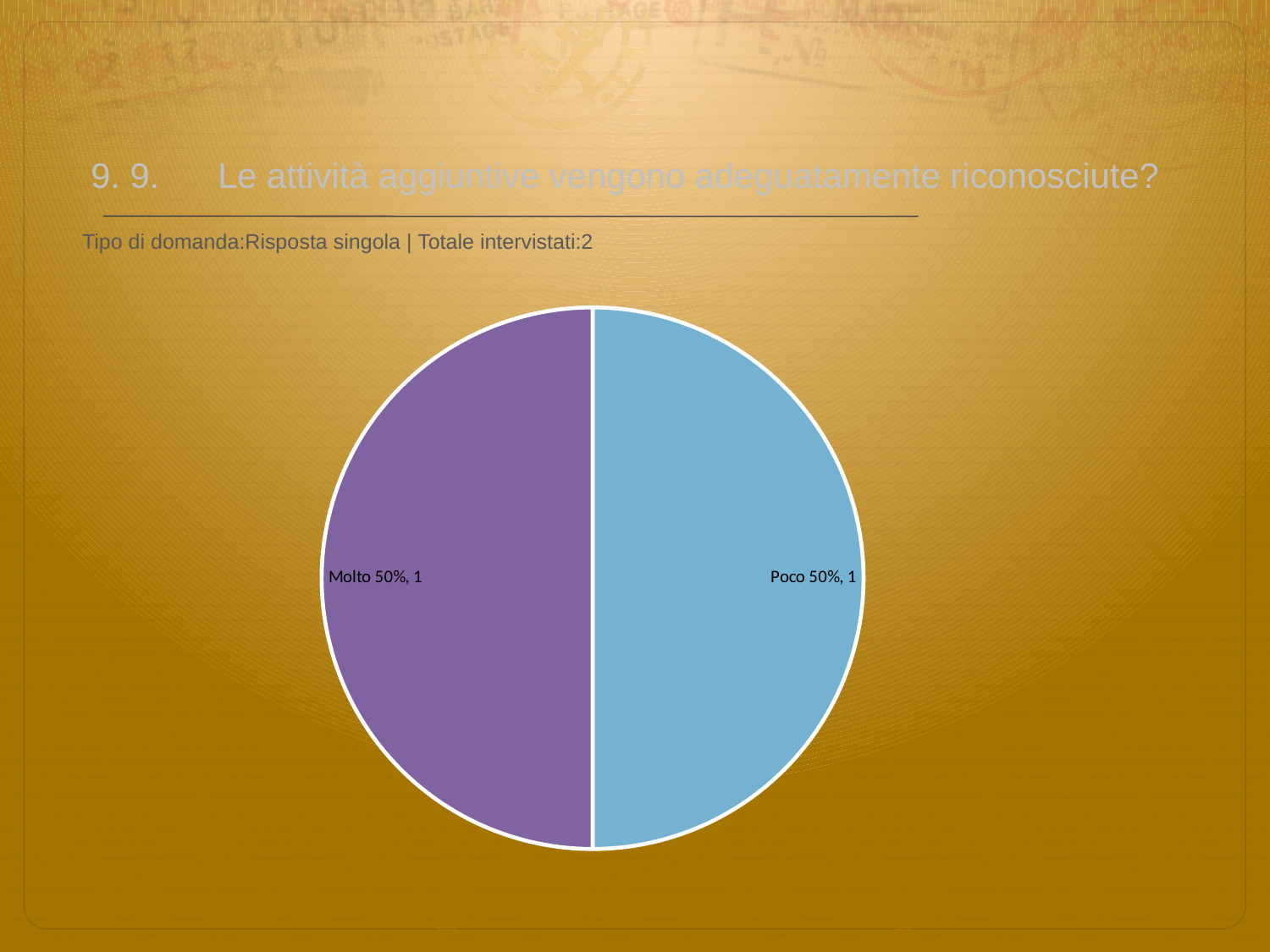
How many slices does the pie chart have? 2 What is the count value shown for Poco? 1 What is the total number of respondents stated on the slide? 2 What is the total of the values for Molto and Poco? 2 What percentage share does the Molto slice have? 50% What colour is the Poco slice? blue What kind of chart is shown on the slide? pie chart What is the difference between the values for Molto and Poco? 0 What is the count value shown for Molto? 1 What percentage share does the Poco slice have? 50%